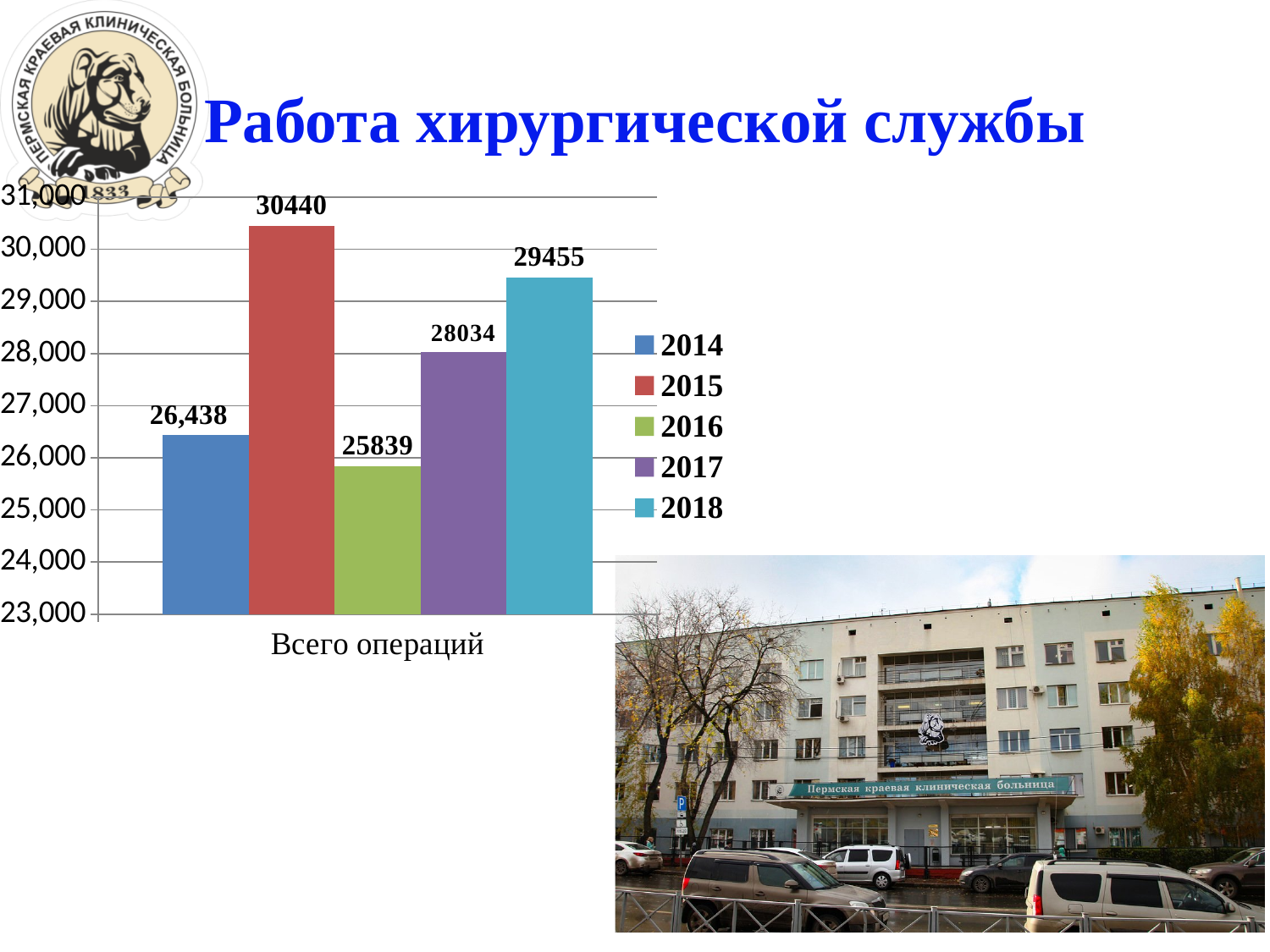
Which is larger, the value for 2017 or the value for 2018? 2018 What is the value for 2014 in the chart? 26,438 What kind of chart is shown on the slide? Bar chart What is the category label shown on the x axis of the chart? Всего операций What is the difference between the values for 2017 and 2014? 1596 Which year has the lowest value in the chart? 2016 What is the difference between the values for 2015 and 2018? 985 What is the value for 2018 in the chart? 29455 How many series does the legend list? 5 What is the value for 2016 in the chart? 25839 What is the value for 2015 in the chart? 30440 Which year has the highest value in the chart? 2015